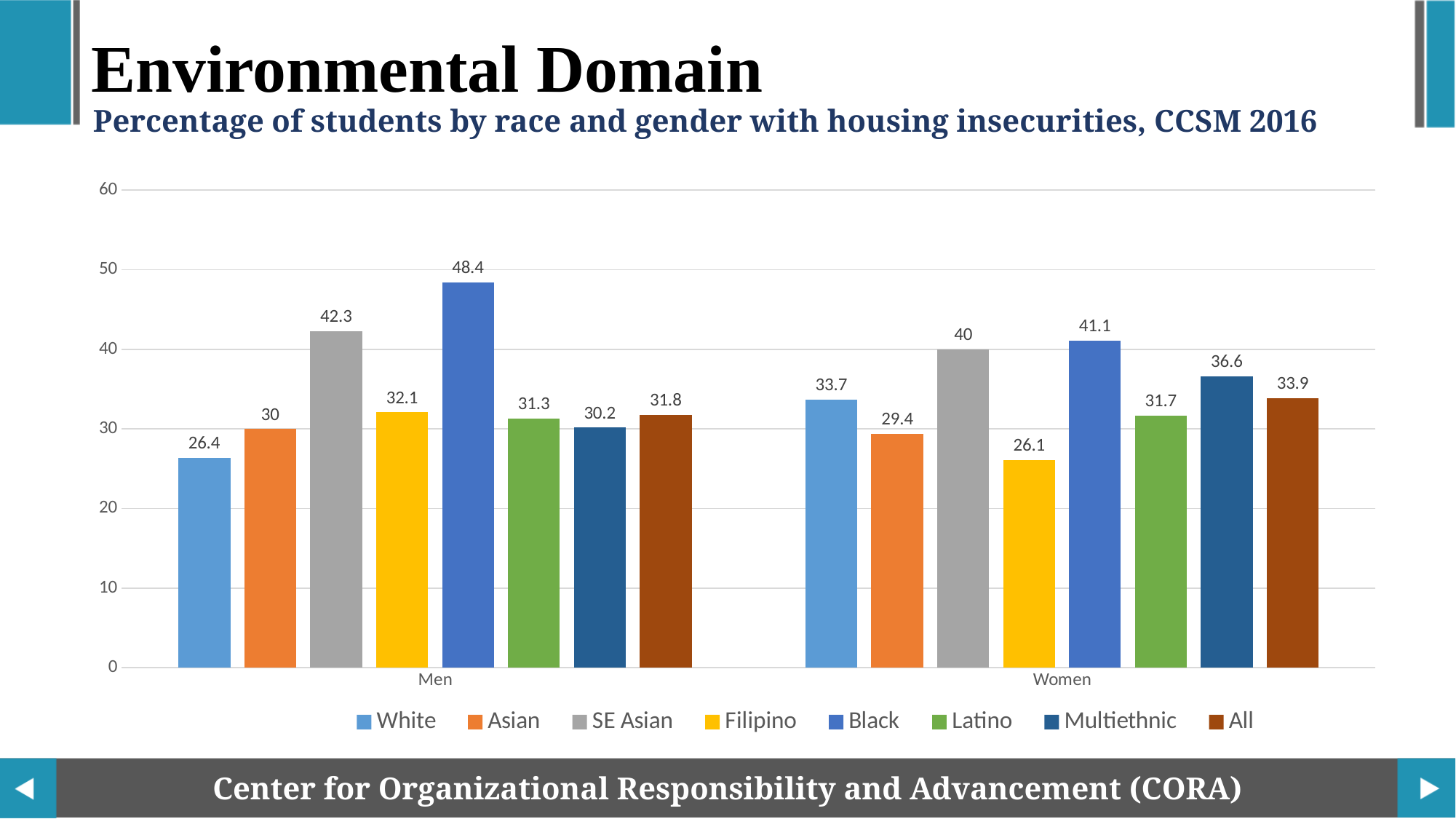
Is the value for SE Asian students in the Men group greater or less than 40? greater What kind of chart is shown on the slide? Bar chart What is the value for SE Asian students in the Women group? 40 What is the value for All students in the Men group? 31.8 What is the value for Filipino students in the Women group? 26.1 Which is larger: the White value for Men or the White value for Women? Women How many series does the legend list? 8 How many categories are shown on the x axis? 2 What is the value for Black students in the Men group? 48.4 Which series has the lowest value in the Women group? Filipino What is the difference between the Black value for Men and the Black value for Women? 7.3 Which series has the highest value in the Men group? Black